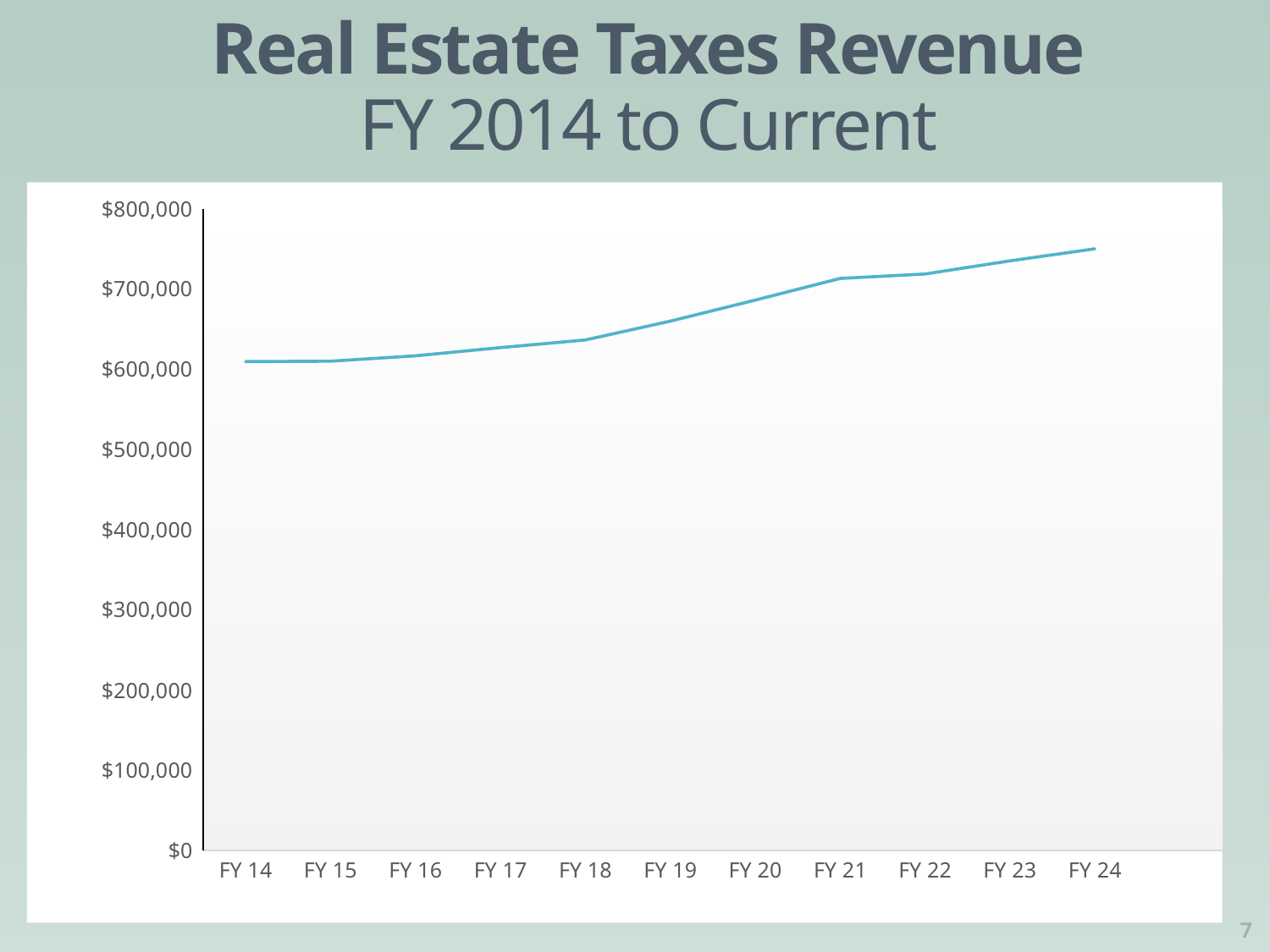
Is the value for FY 21 greater or less than $700,000? greater Is the value for FY 14 greater or less than $600,000? greater Which fiscal year has the highest real estate taxes revenue? FY 24 How many fiscal years are plotted on the x axis? 11 Is the value for FY 18 greater or less than $700,000? less What is the title of the chart on the slide? Real Estate Taxes Revenue FY 2014 to Current What kind of chart is shown on the slide? line chart Which is larger, the value for FY 24 or the value for FY 14? FY 24 Which is larger, the value for FY 21 or the value for FY 18? FY 21 Do the real estate tax revenue values generally rise or fall from FY 14 to FY 24? rise